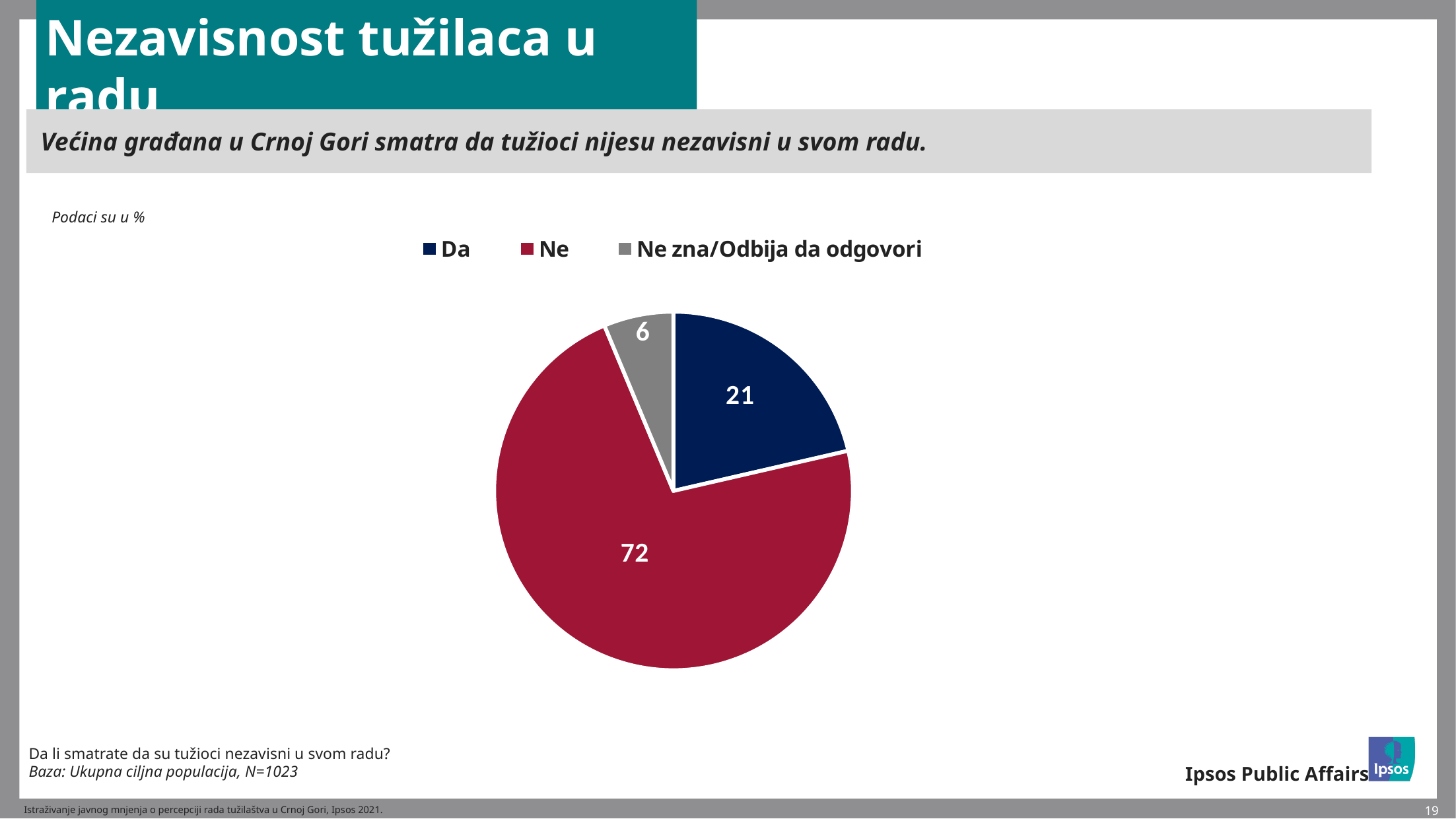
Which is larger, the value for "Da" or the value for "Ne zna/Odbija da odgovori"? Da What type of chart is shown on the slide? pie chart How many entries does the legend list? 3 What colour is the slice for "Ne"? red What is the value for "Ne" in the pie chart? 72 What is the value for "Ne zna/Odbija da odgovori" in the pie chart? 6 Which category has the smallest slice in the pie chart? Ne zna/Odbija da odgovori Which category has the largest slice in the pie chart? Ne How many slices does the pie chart have? 3 What is the value for "Da" in the pie chart? 21 What is the difference between the values for "Ne" and "Da"? 51 What is the difference between the values for "Da" and "Ne zna/Odbija da odgovori"? 15